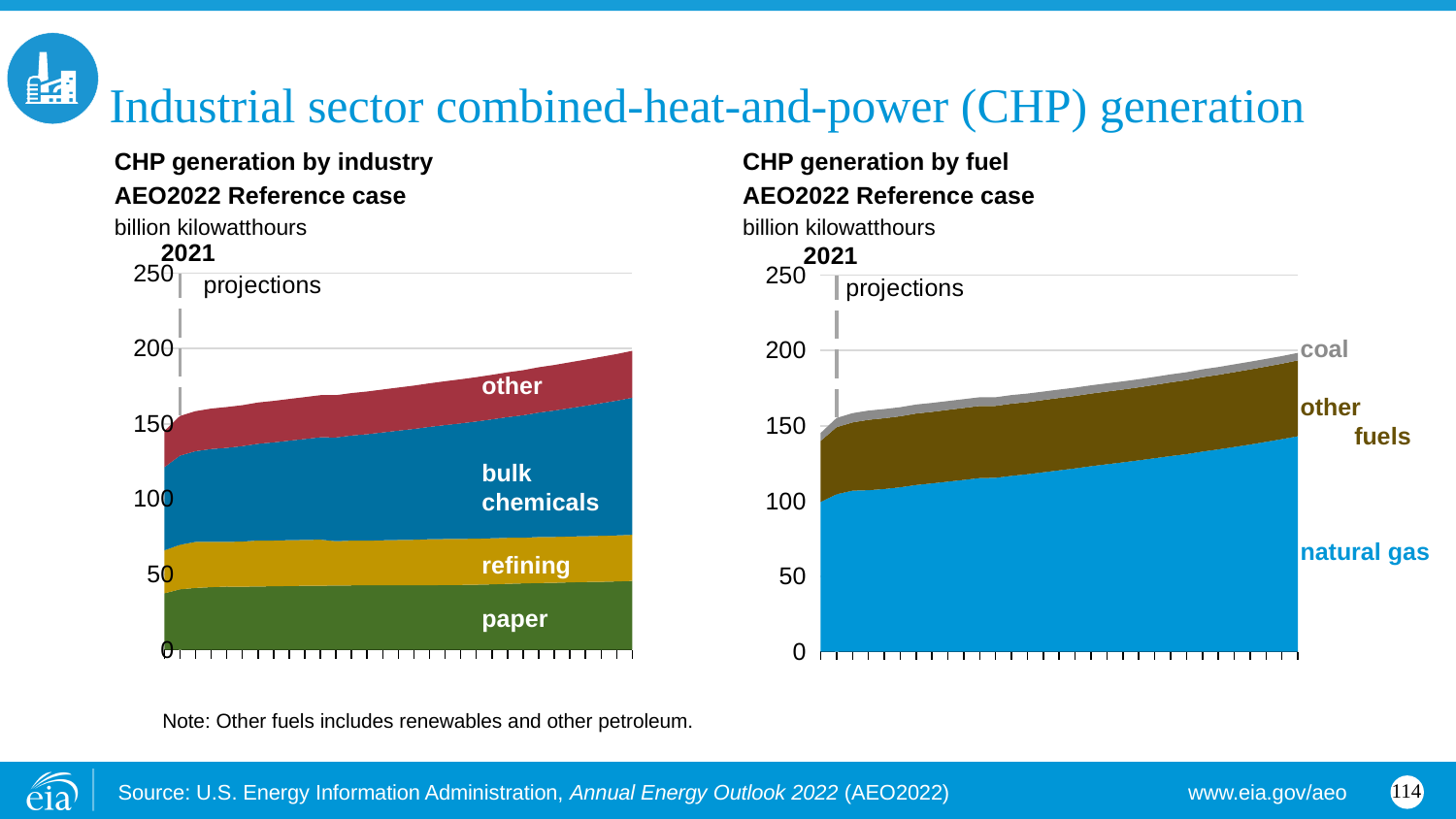
In the 'CHP generation by fuel' chart, which fuel accounts for the largest share of CHP generation? natural gas In the 'CHP generation by industry' chart, which industry accounts for the largest share of CHP generation? bulk chemicals What type of chart is the 'CHP generation by industry' chart? stacked area chart In the 'CHP generation by industry' chart, is CHP generation from paper at the start of the projection period greater or less than 50 billion kilowatthours? less In the 'CHP generation by fuel' chart, is natural gas CHP generation at the end of the projection period greater or less than 100 billion kilowatthours? greater How many series are shown in the 'CHP generation by fuel' chart? 3 How many series are shown in the 'CHP generation by industry' chart? 4 In the 'CHP generation by industry' chart, is total CHP generation at the end of the projection period greater or less than 150 billion kilowatthours? greater In the 'CHP generation by fuel' chart, which fuel accounts for the smallest share of CHP generation? coal What unit is used on the y axis of both charts? billion kilowatthours In the 'CHP generation by industry' chart, does total CHP generation rise or fall over the projection period? rise In the 'CHP generation by fuel' chart, does total CHP generation rise or fall over the projection period? rise